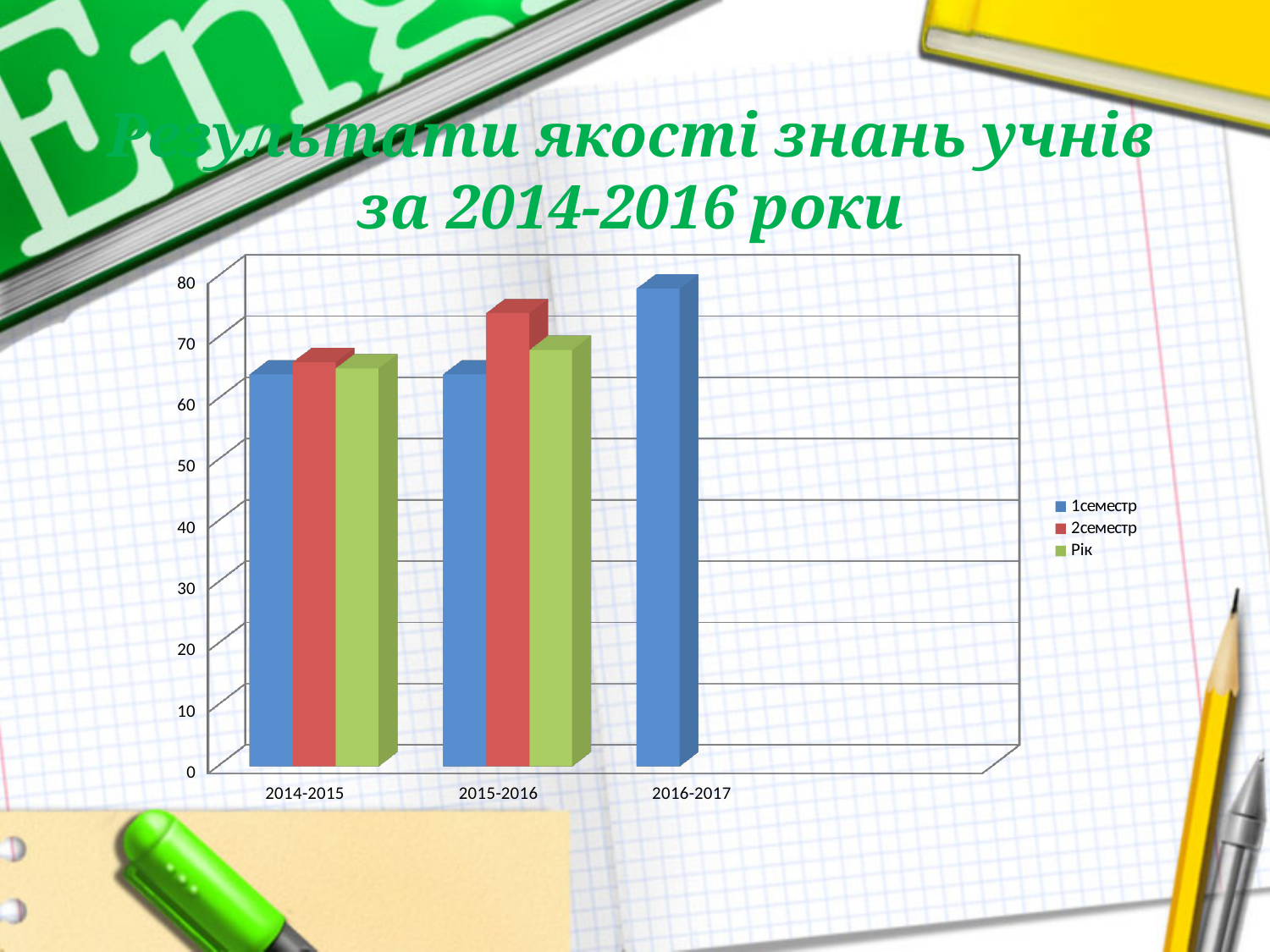
How many series does the legend list? 3 What kind of chart is shown on the slide? bar chart Which is larger: 2семестр in 2014-2015 or 2семестр in 2015-2016? 2015-2016 Which series is shown in red in the legend? 2семестр Is the value for 1семестр in 2015-2016 greater or less than 70? less How many bars are plotted for the 2016-2017 category? 1 Which year has the highest value for 2семестр? 2015-2016 Which year has the highest value for 1семестр? 2016-2017 How many year categories are shown on the x axis? 3 Is the value for 1семестр in 2014-2015 greater or less than 70? less Is the value for 1семестр in 2016-2017 greater or less than 70? greater